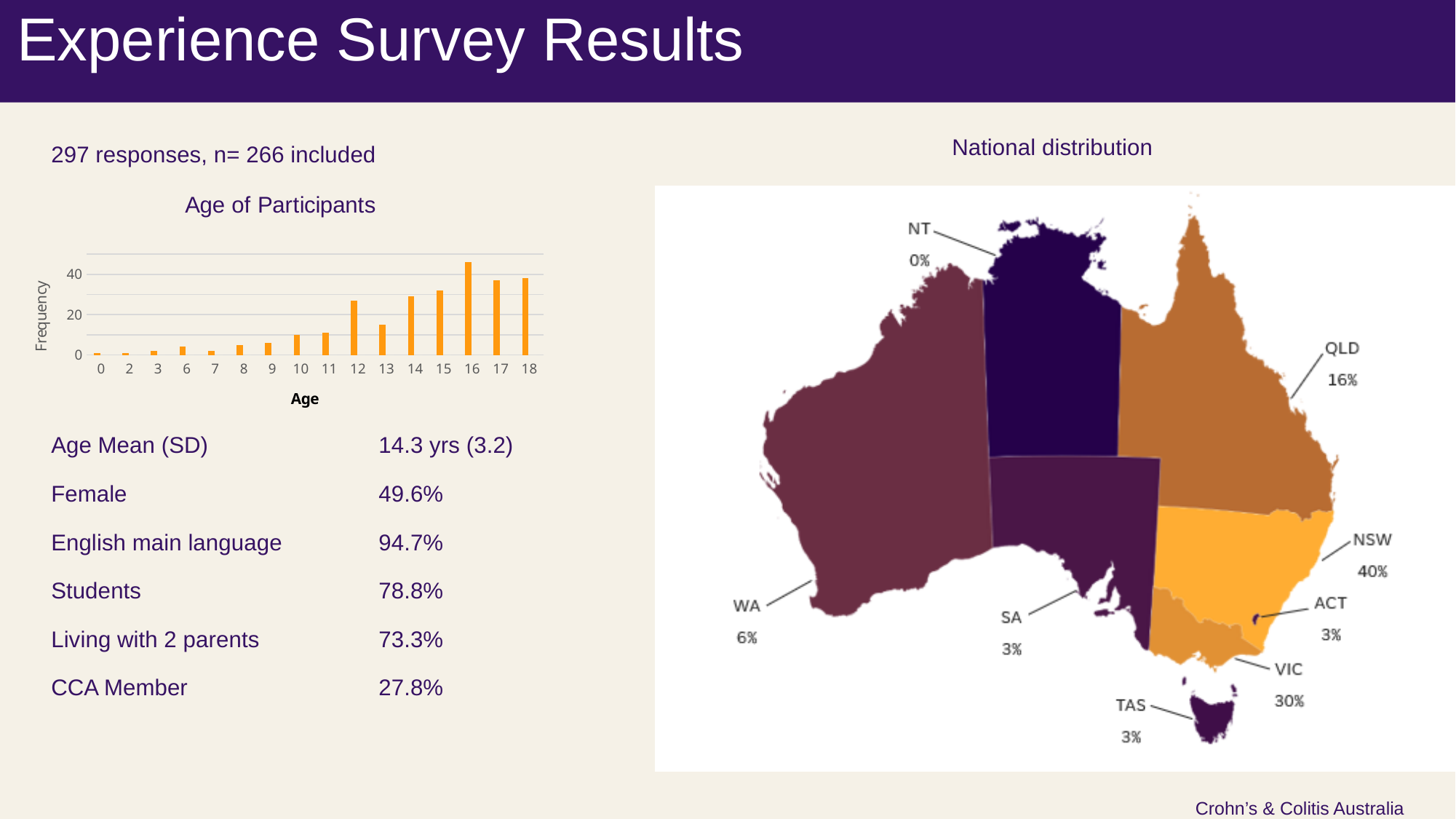
In the Age of Participants chart, how many age categories are shown on the x axis? 16 In the Age of Participants chart, which age has the highest frequency? 16 In the Age of Participants chart, what kind of chart is used? bar chart In the National distribution map, which state or territory has the lowest percentage? NT In the Age of Participants chart, what is the label of the y axis? Frequency In the National distribution map, what is the difference between the percentages for NSW and VIC? 10% In the Age of Participants chart, is the frequency for age 16 greater or less than 40? greater In the Age of Participants chart, is the frequency for age 12 greater or less than 20? greater In the Age of Participants chart, do frequencies generally rise or fall as age increases? rise In the Age of Participants chart, is the frequency for age 13 greater or less than 20? less In the Age of Participants chart, which has the higher frequency, age 12 or age 13? 12 In the National distribution map, what percentage is shown for NSW? 40%